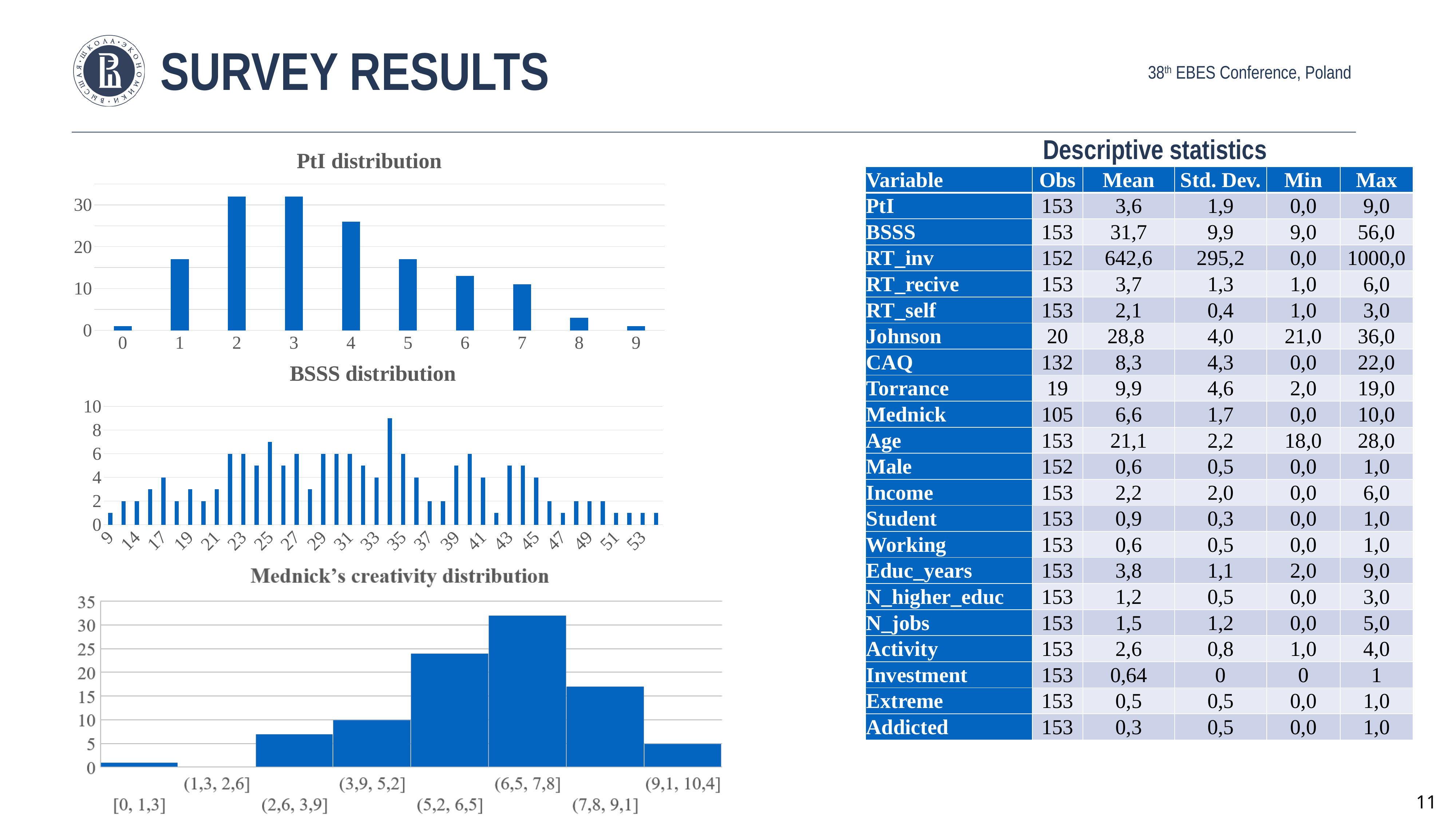
In the Mednick's creativity distribution chart, which bin has the highest bar? (6,5, 7,8] In the Mednick's creativity distribution chart, what is the value for the bin (3,9, 5,2]? 10 What kind of chart is the PtI distribution chart? bar chart In the Mednick's creativity distribution chart, which is larger, the value for (6,5, 7,8] or the value for (7,8, 9,1]? (6,5, 7,8] In the Mednick's creativity distribution chart, what is the value for the bin (9,1, 10,4]? 5 In the Mednick's creativity distribution chart, is the value for (6,5, 7,8] greater or less than 30? greater In the PtI distribution chart, which is larger, the value for 4 or the value for 5? 4 In the PtI distribution chart, is the value for 1 greater or less than 20? less In the PtI distribution chart, is the value for 4 greater or less than 20? greater In the PtI distribution chart, how many categories are shown on the x axis? 10